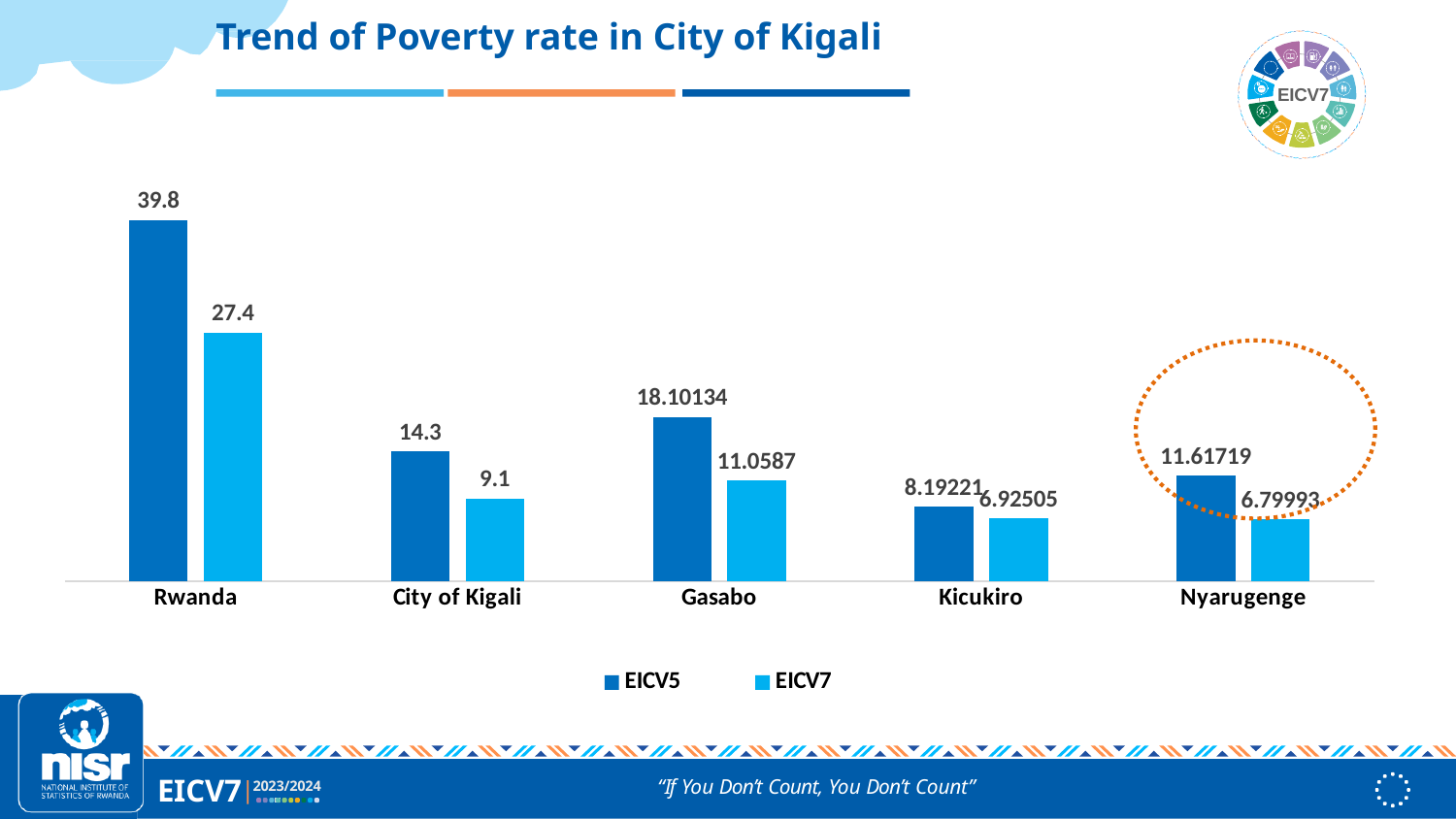
What is the EICV7 poverty rate for City of Kigali? 9.1 What is the EICV5 poverty rate for Rwanda? 39.8 What type of chart is shown on the slide? Bar chart How many categories are shown on the x axis? 5 Which category has the highest EICV5 value? Rwanda What is the difference between the EICV5 and EICV7 values for City of Kigali? 5.2 How many series does the legend list? 2 What is the EICV5 value for Nyarugenge? 11.61719 What is the difference between the EICV5 and EICV7 values for Rwanda? 12.4 Which category has the lowest EICV7 value? Nyarugenge Which is larger, the EICV5 value for Gasabo or the EICV5 value for Kicukiro? Gasabo What is the EICV7 value for Gasabo? 11.0587